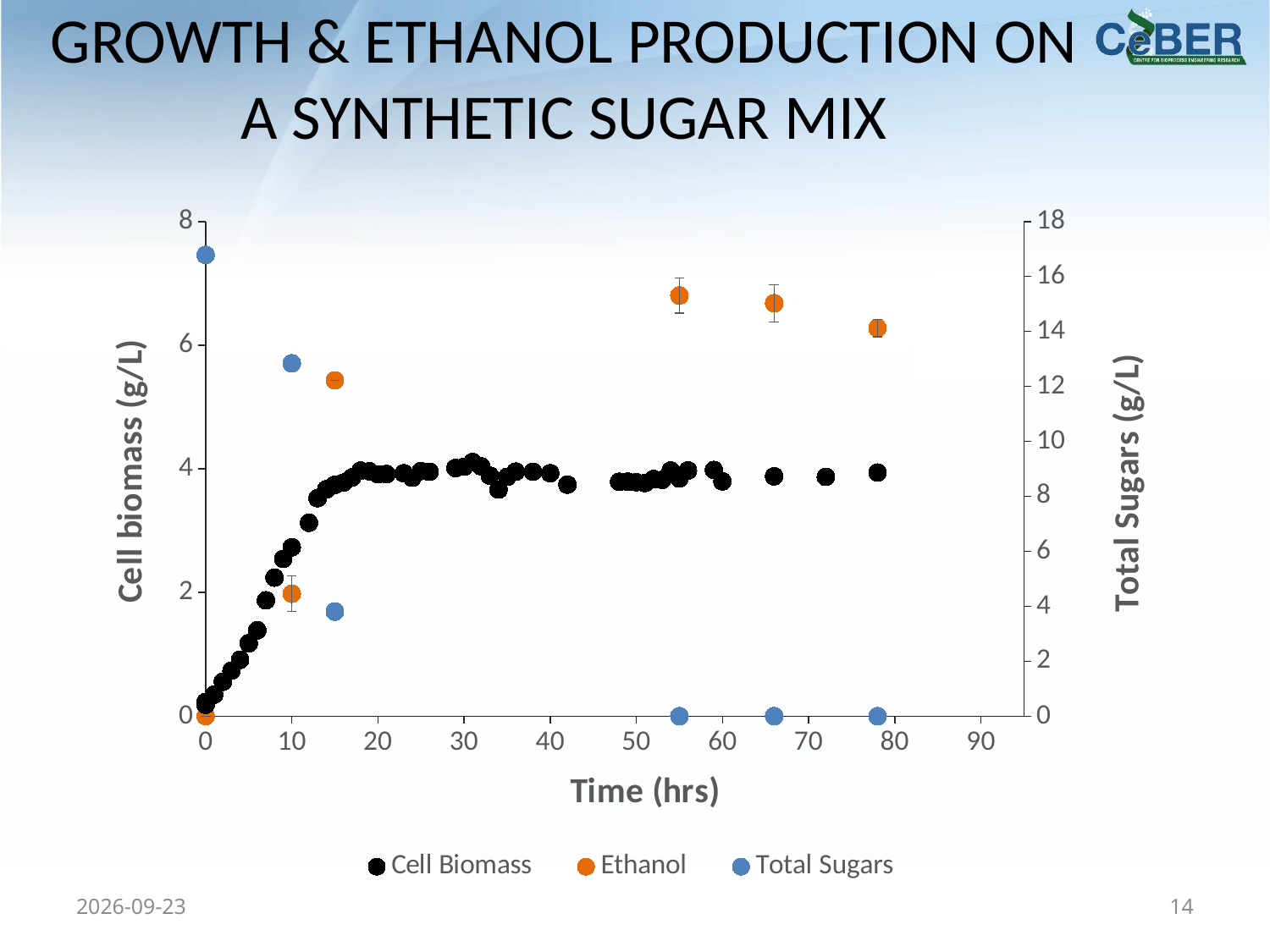
What kind of chart is shown on the slide? Scatter chart What is the title of the x axis? Time (hrs) Is the Total Sugars value at 0 hrs greater or less than 16 g/L? greater What is the Ethanol value at 0 hrs? 0 How many series does the legend list? 3 Is the Total Sugars value at 10 hrs greater or less than 12 g/L? greater At which time is the Total Sugars value highest? 0 hrs Is the Cell Biomass value at 0 hrs greater or less than 1 g/L? less Do the Total Sugars values rise or fall as time increases? Fall Which is larger, the Total Sugars value at 10 hrs or at 15 hrs? 10 hrs What is the Total Sugars value at 78 hrs? 0 What are the three series listed in the legend? Cell Biomass, Ethanol, Total Sugars